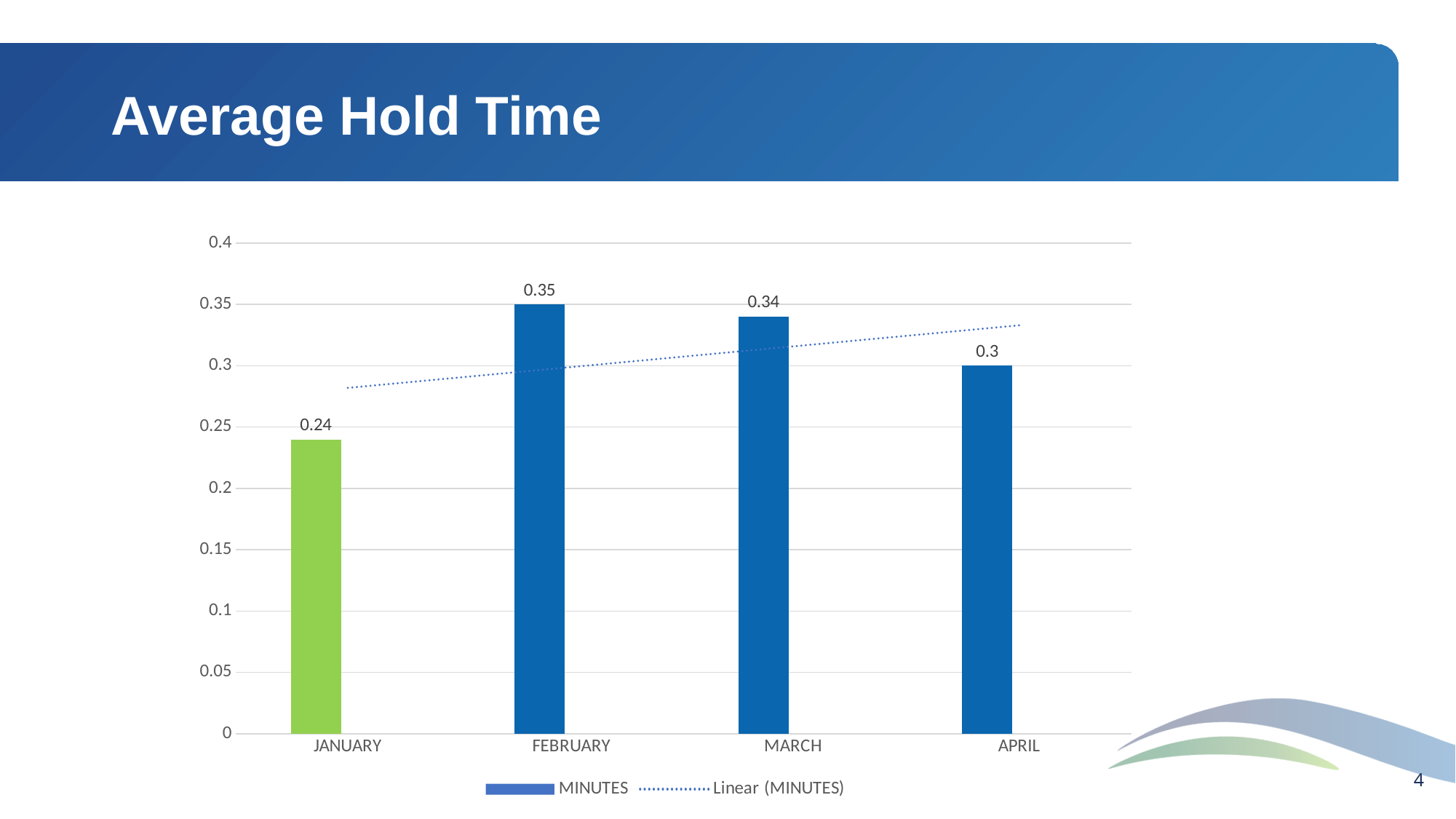
How many entries does the legend list? 2 How many months are shown on the x axis? 4 What is the value for FEBRUARY? 0.35 What is the title of the slide? Average Hold Time What kind of chart is shown on the slide? bar chart Is the value for JANUARY greater or less than 0.25? less Which month has the highest value? FEBRUARY Which is larger, the value for MARCH or the value for APRIL? MARCH What is the difference between the values for FEBRUARY and JANUARY? 0.11 What is the value for JANUARY? 0.24 Which month has the lowest value? JANUARY What is the value for APRIL? 0.3